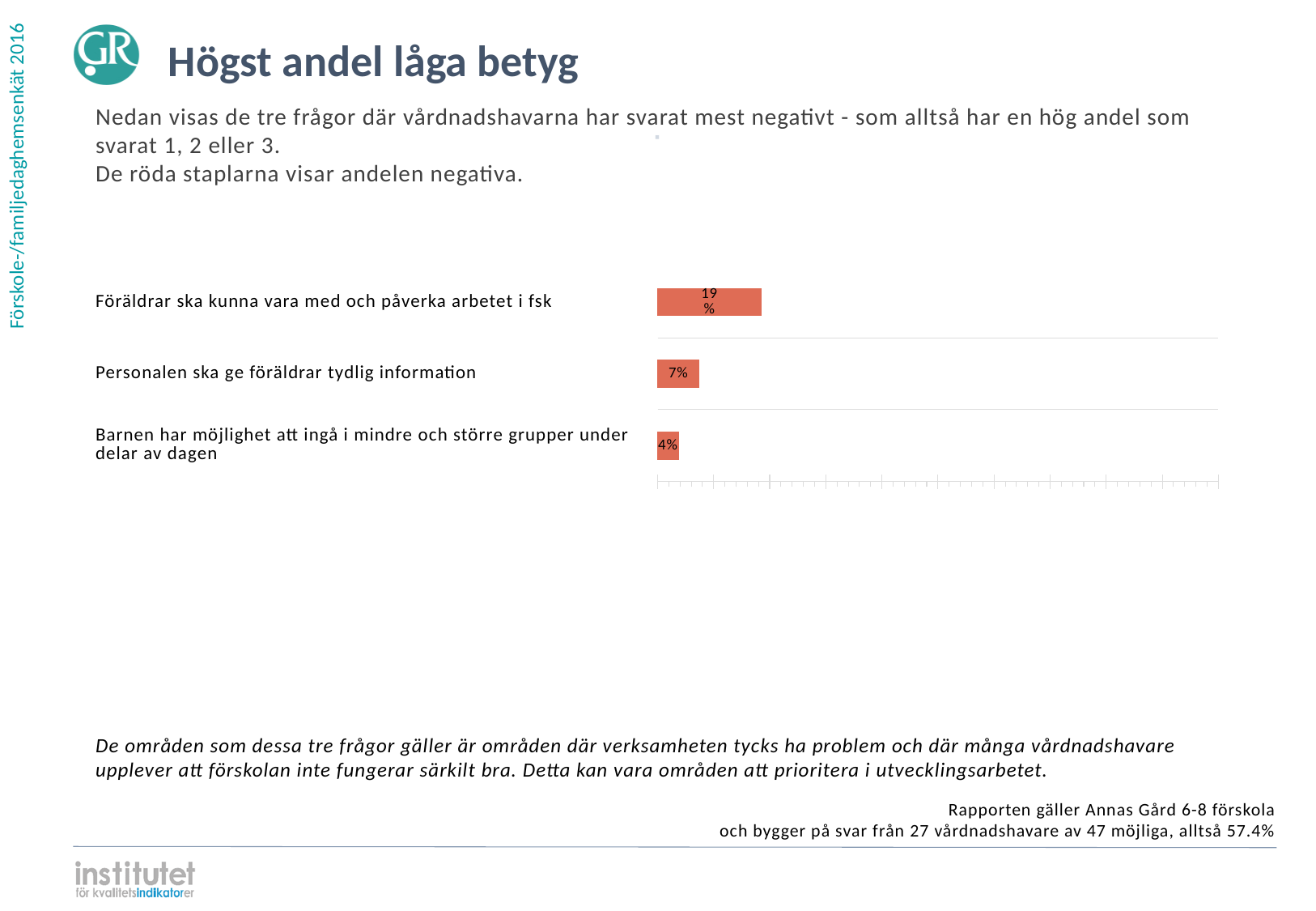
How many categories are shown in the chart? 3 What colour are the bars in the chart? Red What is the value for "Föräldrar ska kunna vara med och påverka arbetet i fsk"? 19% What is the value for "Barnen har möjlighet att ingå i mindre och större grupper under delar av dagen"? 4% What is the title of the slide containing the chart? Högst andel låga betyg Which category has the highest value? Föräldrar ska kunna vara med och påverka arbetet i fsk What is the value for "Personalen ska ge föräldrar tydlig information"? 7% Which is larger: the value for "Personalen ska ge föräldrar tydlig information" or for "Barnen har möjlighet att ingå i mindre och större grupper under delar av dagen"? Personalen ska ge föräldrar tydlig information What is the difference between the values for "Personalen ska ge föräldrar tydlig information" and "Barnen har möjlighet att ingå i mindre och större grupper under delar av dagen"? 3% What is the difference between the values for "Föräldrar ska kunna vara med och påverka arbetet i fsk" and "Personalen ska ge föräldrar tydlig information"? 12% Which category has the lowest value? Barnen har möjlighet att ingå i mindre och större grupper under delar av dagen What kind of chart is shown on the slide? Bar chart